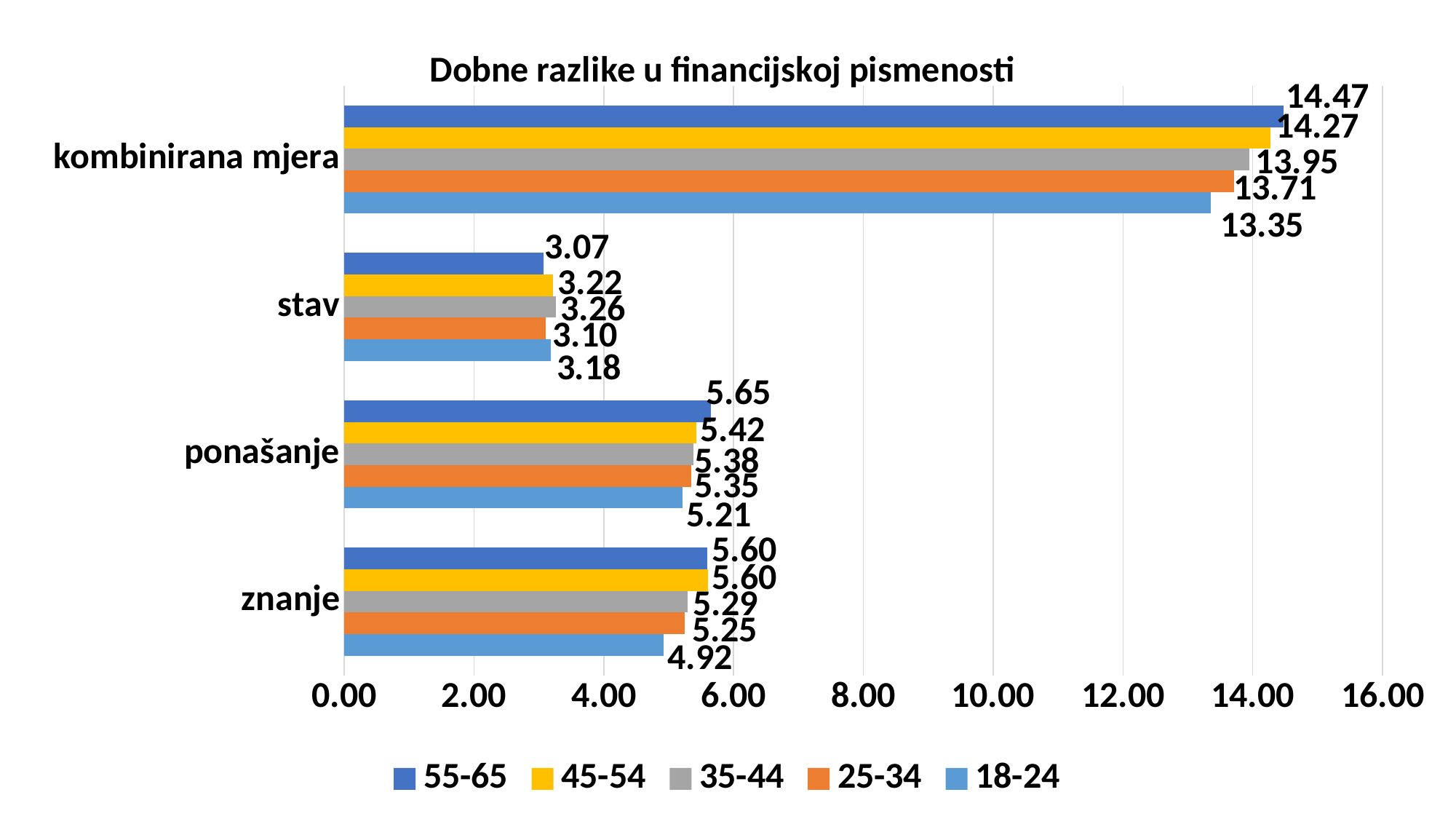
What is the value for the 55-65 group in the kombinirana mjera category? 14.47 What type of chart is shown on the slide? bar chart What is the title of the chart? Dobne razlike u financijskoj pismenosti Which is larger in the znanje category: the value for 25-34 or the value for 18-24? 25-34 Is the value for the 45-54 group in the kombinirana mjera category greater or less than 14.00? greater What is the value for the 35-44 group in the stav category? 3.26 Which age group has the lowest value in the kombinirana mjera category? 18-24 What is the value for the 18-24 group in the znanje category? 4.92 How many categories are shown on the vertical axis? 4 How many series does the legend list? 5 Which age group has the highest value in the ponašanje category? 55-65 What is the difference between the 55-65 and 18-24 values in the kombinirana mjera category? 1.12